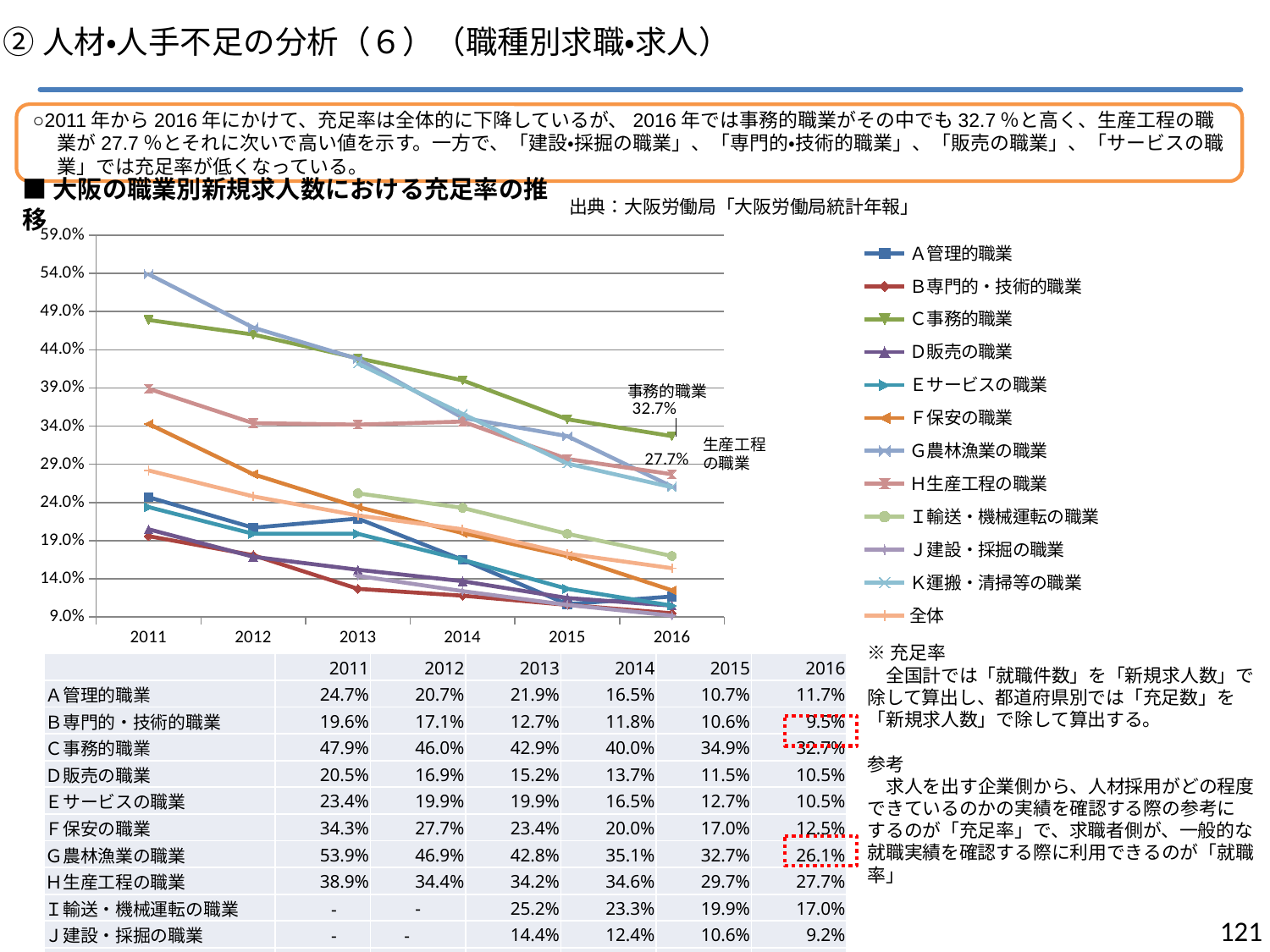
What kind of chart is shown on the slide? line chart What is the difference between C事務的職業 and H生産工程の職業 in 2016? 5.0% How many series does the chart's legend list? 12 What is the value for H生産工程の職業 in 2016? 27.7% Which occupation has the highest value in 2011? G農林漁業の職業 What is the value for G農林漁業の職業 in 2011? 53.9% What is the value for C事務的職業 in 2016? 32.7% Does the value for G農林漁業の職業 rise or fall from 2011 to 2016? fall Is the value for C事務的職業 in 2011 greater or less than 44.0%? greater Which occupation has the lowest value in 2016? J建設・採掘の職業 How many years are shown along the x axis of the chart? 6 Which is larger in 2014, F保安の職業 or Eサービスの職業? F保安の職業